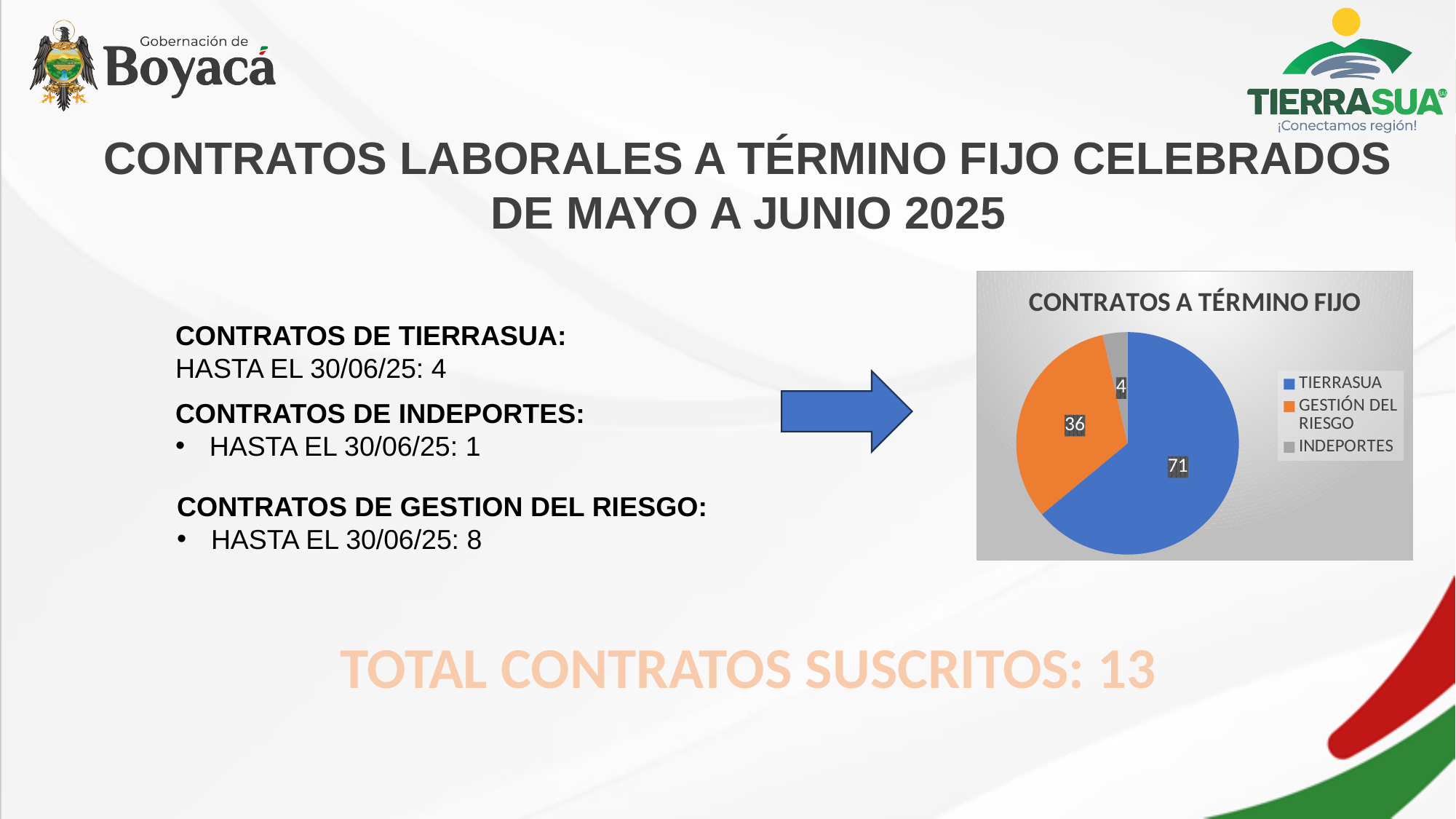
How many entries does the chart legend list? 3 What value is labelled on the INDEPORTES slice? 4 What value is labelled on the TIERRASUA slice? 71 What type of chart is shown on the slide? pie chart What colour is the GESTIÓN DEL RIESGO slice in the pie chart? orange What value is labelled on the GESTIÓN DEL RIESGO slice? 36 What is the title of the chart? CONTRATOS A TÉRMINO FIJO What is the difference between the labelled values for TIERRASUA and GESTIÓN DEL RIESGO? 35 How many slices does the pie chart have? 3 Which is larger, the GESTIÓN DEL RIESGO slice or the INDEPORTES slice? GESTIÓN DEL RIESGO Which slice of the pie chart is the largest? TIERRASUA Which slice of the pie chart is the smallest? INDEPORTES